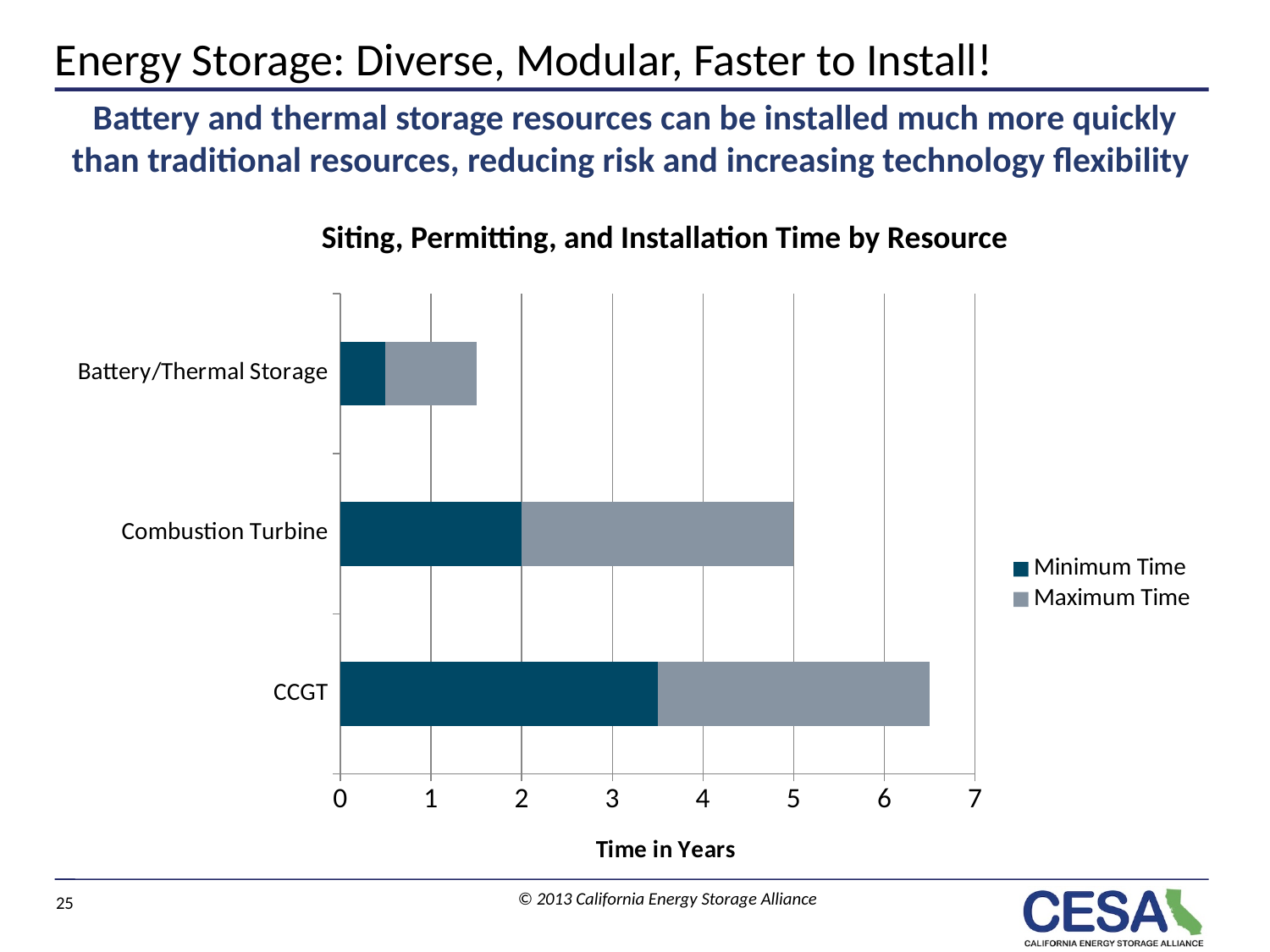
What is the total length of the stacked bar for Combustion Turbine? 5 What is the label of the horizontal axis? Time in Years Which resource has the longest total stacked bar? CCGT What kind of chart is shown on the slide? bar chart Is the total stacked bar for Battery/Thermal Storage greater or less than 2? less What is the Minimum Time value for Combustion Turbine? 2 How many series does the legend list? 2 Which has a larger Minimum Time value, CCGT or Battery/Thermal Storage? CCGT What is the title of the chart? Siting, Permitting, and Installation Time by Resource Is the total stacked bar for CCGT greater or less than 6? greater How many resource categories are shown in the chart? 3 Which resource has the shortest total stacked bar? Battery/Thermal Storage